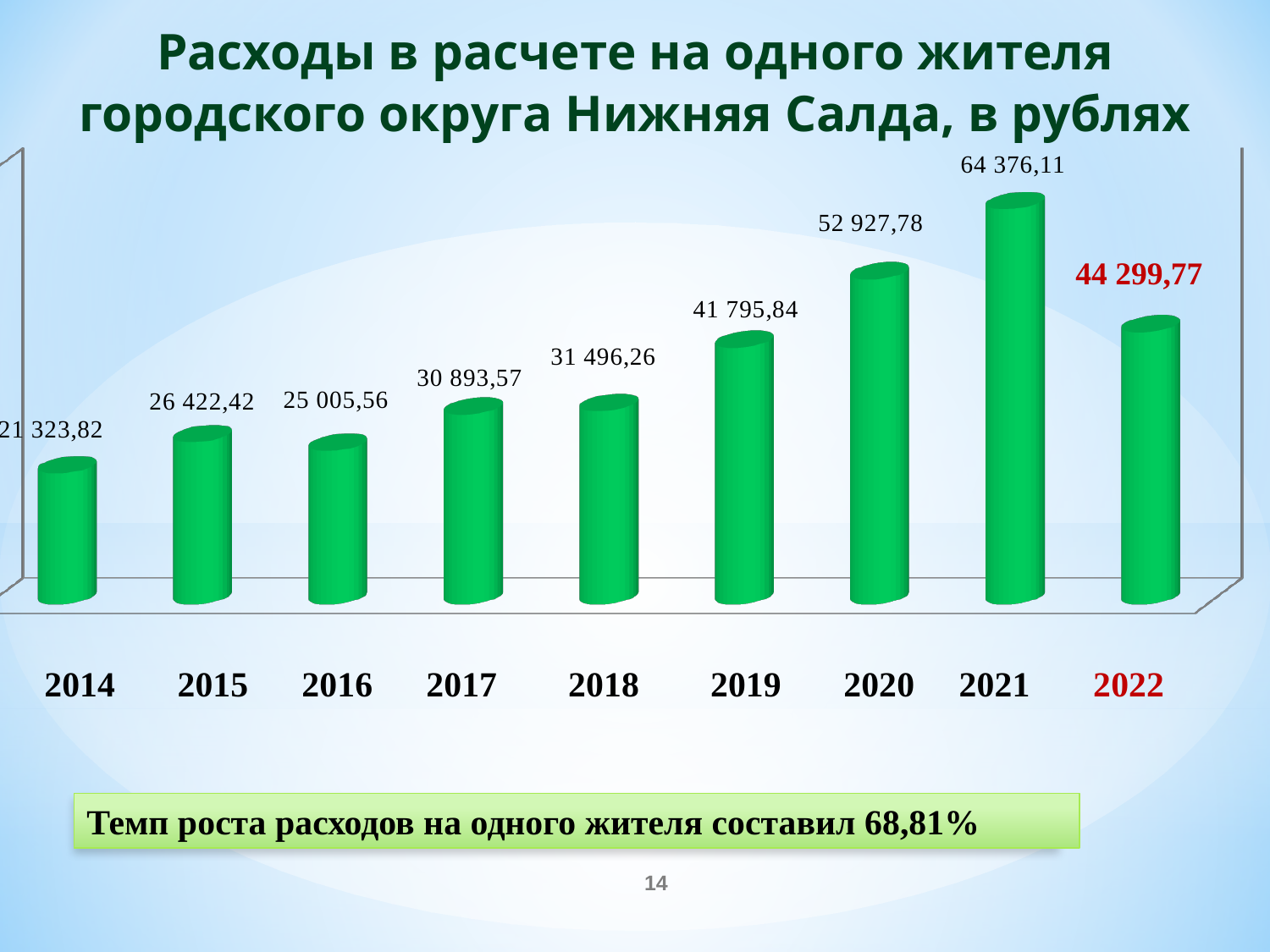
Which is larger, the value for 2015 or the value for 2016? 2015 What type of chart is shown on the slide? bar chart What is the value for 2022? 44 299,77 What is the value for 2019? 41 795,84 Do the values rise or fall from 2019 to 2021? rise What is the difference between the values for 2021 and 2020? 11 448,33 Which year has the highest value? 2021 What is the value for 2021? 64 376,11 How many years are shown on the x axis? 9 What is the value for 2016? 25 005,56 Which year has the lowest value? 2014 What is the difference between the values for 2021 and 2022? 20 076,34